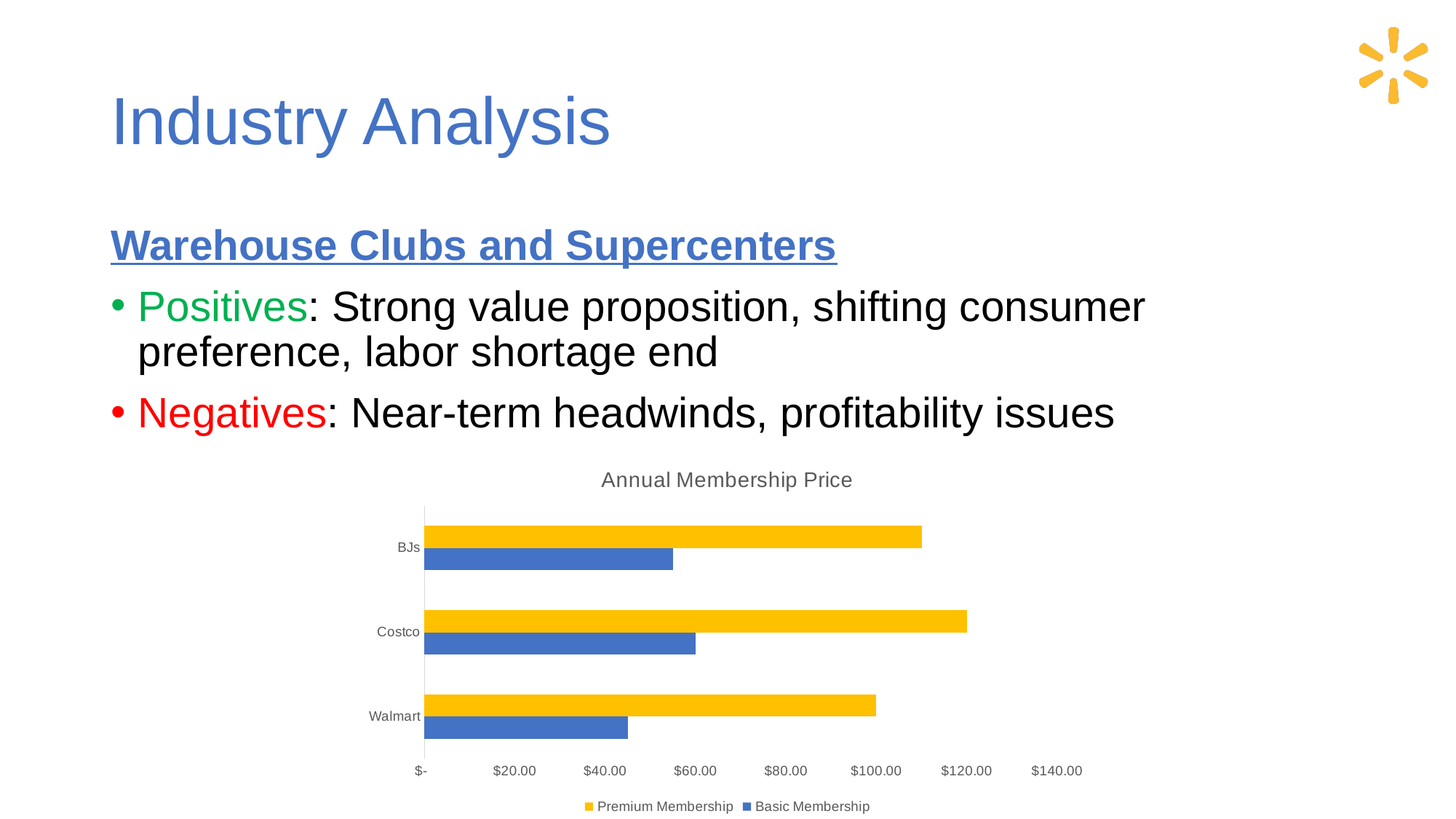
Which company has the lowest Basic Membership price? Walmart Is the Basic Membership price for Walmart greater or less than $60.00? less How many series does the chart legend list? 2 Is the Premium Membership price for BJs greater or less than $100.00? greater Which is larger: the Basic Membership price for BJs or for Walmart? BJs Which colour represents Premium Membership in the chart? yellow What is the title of the chart? Annual Membership Price Which is larger: the Premium Membership price for Costco or for Walmart? Costco Which company has the highest Premium Membership price? Costco Is the Basic Membership price for BJs greater or less than $40.00? greater What kind of chart is shown on the slide? bar chart How many companies are shown on the chart? 3